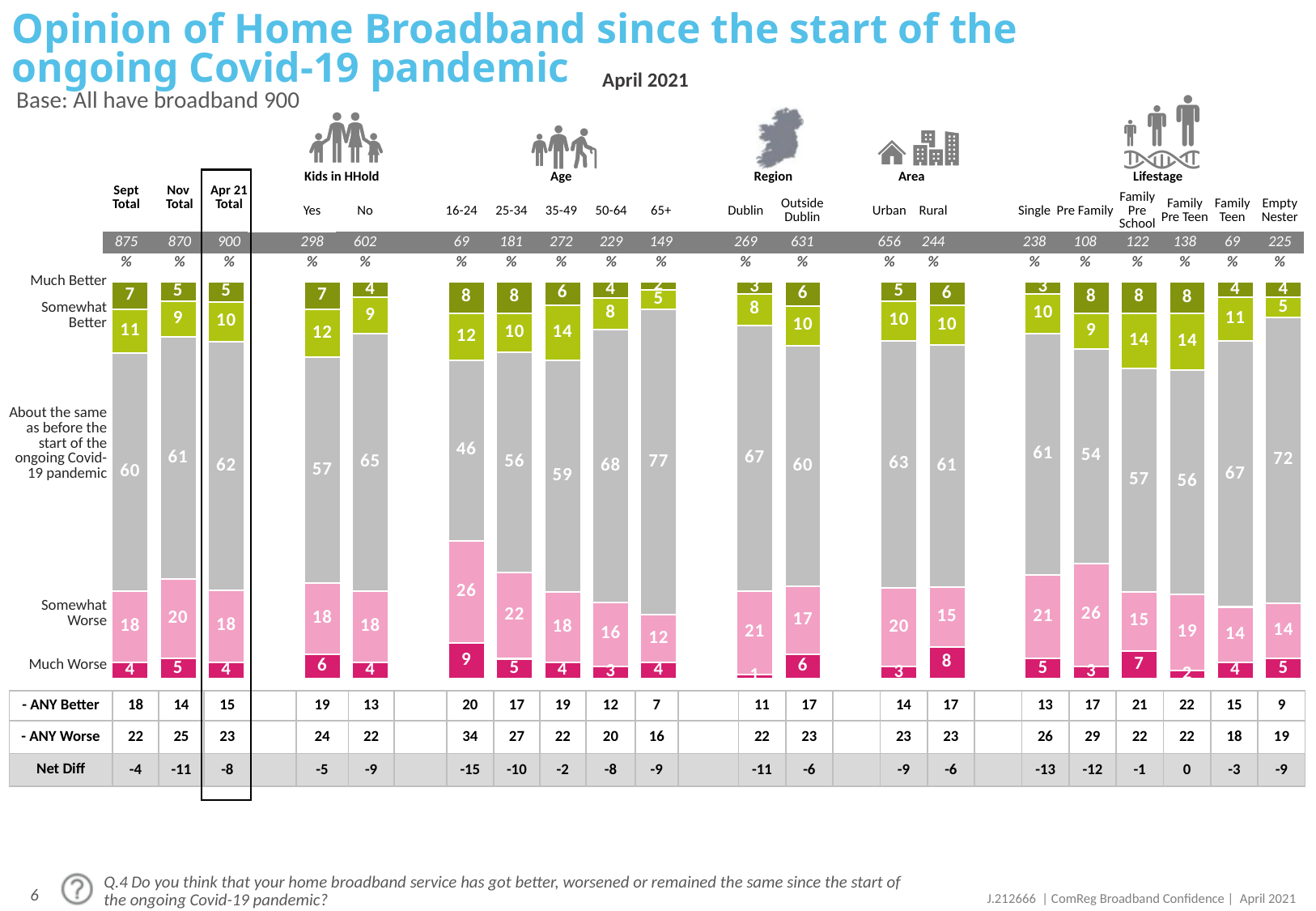
What percentage of the Apr 21 Total say their broadband is about the same as before the start of the pandemic? 62 What percentage of the 16-24 age group say their broadband is somewhat worse? 26 What is the difference in the Somewhat Worse percentage between Dublin and Outside Dublin? 4 Which has a larger Somewhat Better percentage: households with kids (Yes) or without kids (No)? Yes Which age group has the highest share saying their broadband is about the same as before? 65+ Which age group has the lowest share saying their broadband is about the same as before? 16-24 What is the Net Diff value for the Family Pre Teen lifestage? 0 What kind of chart is used to show the opinion of home broadband on this slide? Stacked bar chart How many age groups are shown in the Age section of the chart? 5 What is the base size shown for the Apr 21 Total column? 900 What is the ANY Worse value for the 16-24 age group? 34 What percentage of Rural respondents say their broadband is much worse? 8